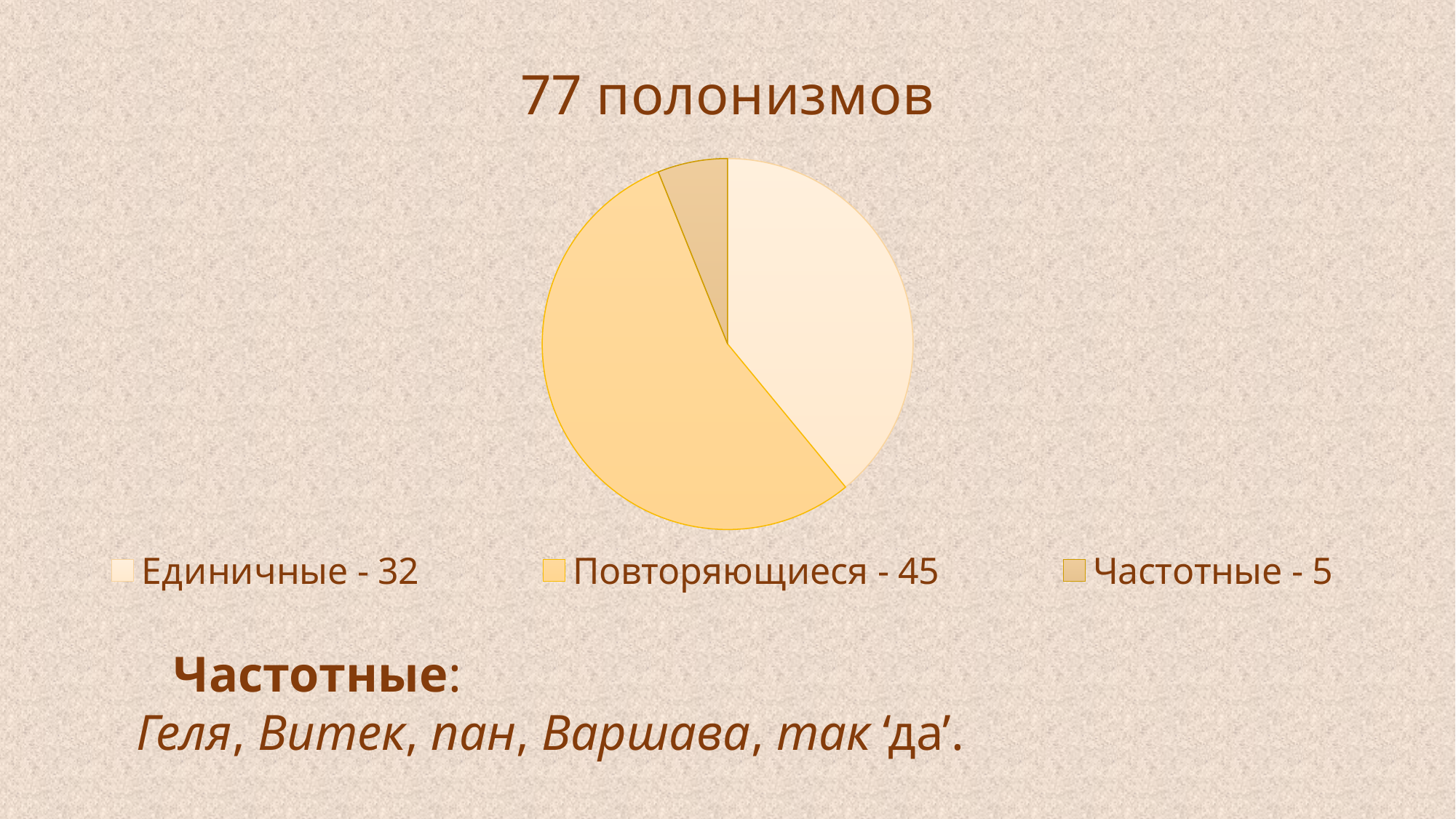
What is the title of the chart? 77 полонизмов How many entries does the legend list? 3 What value is given for Единичные in the legend? 32 Which is larger, the value for Единичные or the value for Частотные? Единичные What is the difference between the values for Повторяющиеся and Единичные? 13 Which category has the smallest slice of the pie? Частотные What is the difference between the values for Единичные and Частотные? 27 What kind of chart is shown on the slide? pie chart What value is given for Повторяющиеся in the legend? 45 Which category has the largest slice of the pie? Повторяющиеся What value is given for Частотные in the legend? 5 How many slices does the pie chart have? 3